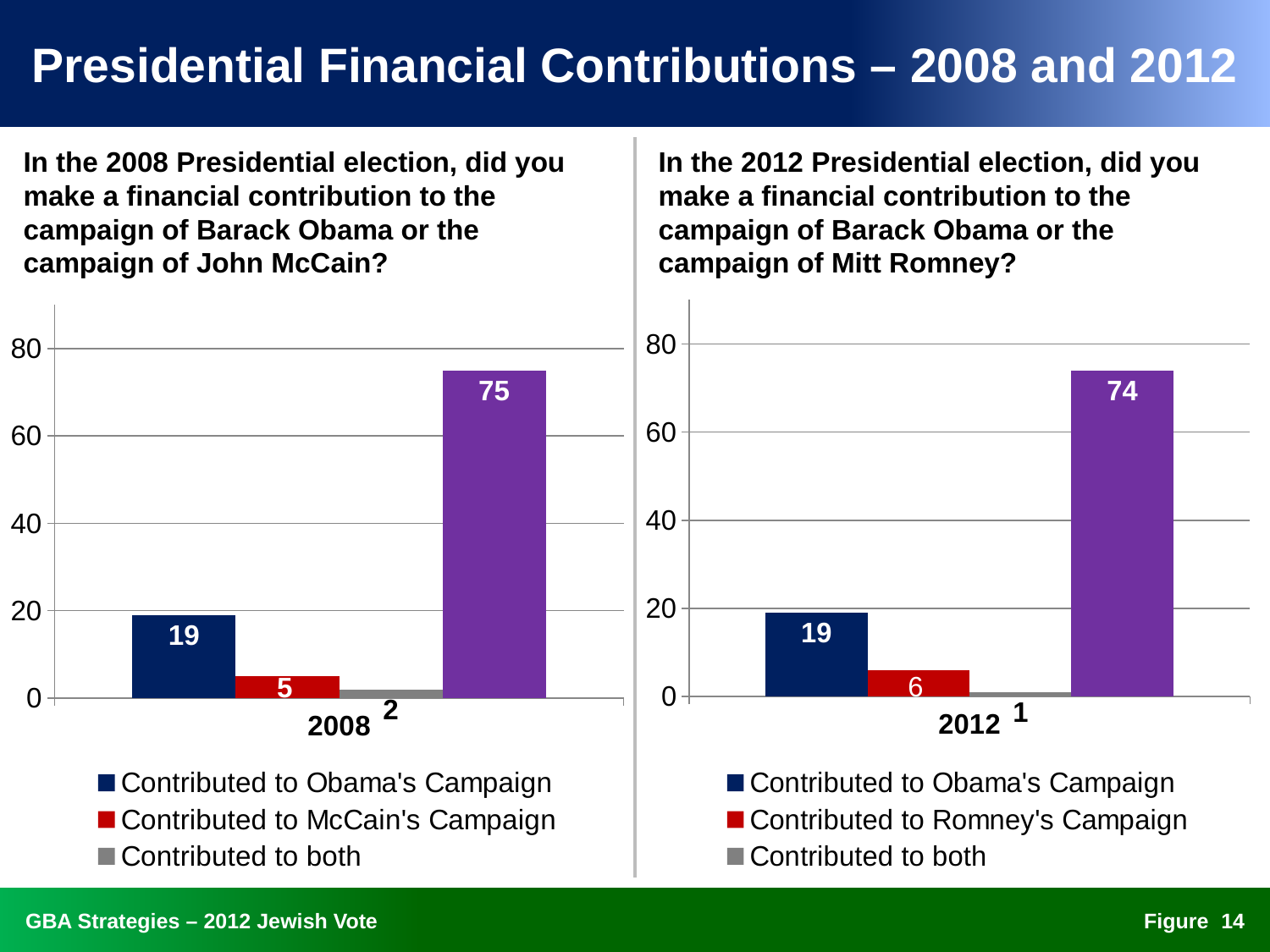
In the 2012 chart on the right, what is the value for Contributed to both? 1 In the 2008 chart on the left, what is the value for Contributed to both? 2 How many series does the legend of the 2012 chart on the right list? 3 In the 2012 chart on the right, is the value for Contributed to Obama's Campaign greater or less than 20? less In the 2008 chart on the left, what percentage contributed to Obama's campaign? 19 What type of chart is the 2008 chart on the left? bar chart In the 2008 chart on the left, what is the difference between the value for Contributed to Obama's Campaign and the value for Contributed to McCain's Campaign? 14 In the 2012 chart on the right, what value is shown on the purple bar? 74 Which is larger: the value for Contributed to McCain's Campaign in the 2008 chart or the value for Contributed to Romney's Campaign in the 2012 chart? Contributed to Romney's Campaign in the 2012 chart In the 2008 chart on the left, which legend category has the lowest value? Contributed to both In the 2012 chart on the right, what is the value for Contributed to Romney's Campaign? 6 In the 2008 chart on the left, what is the value for Contributed to McCain's Campaign? 5